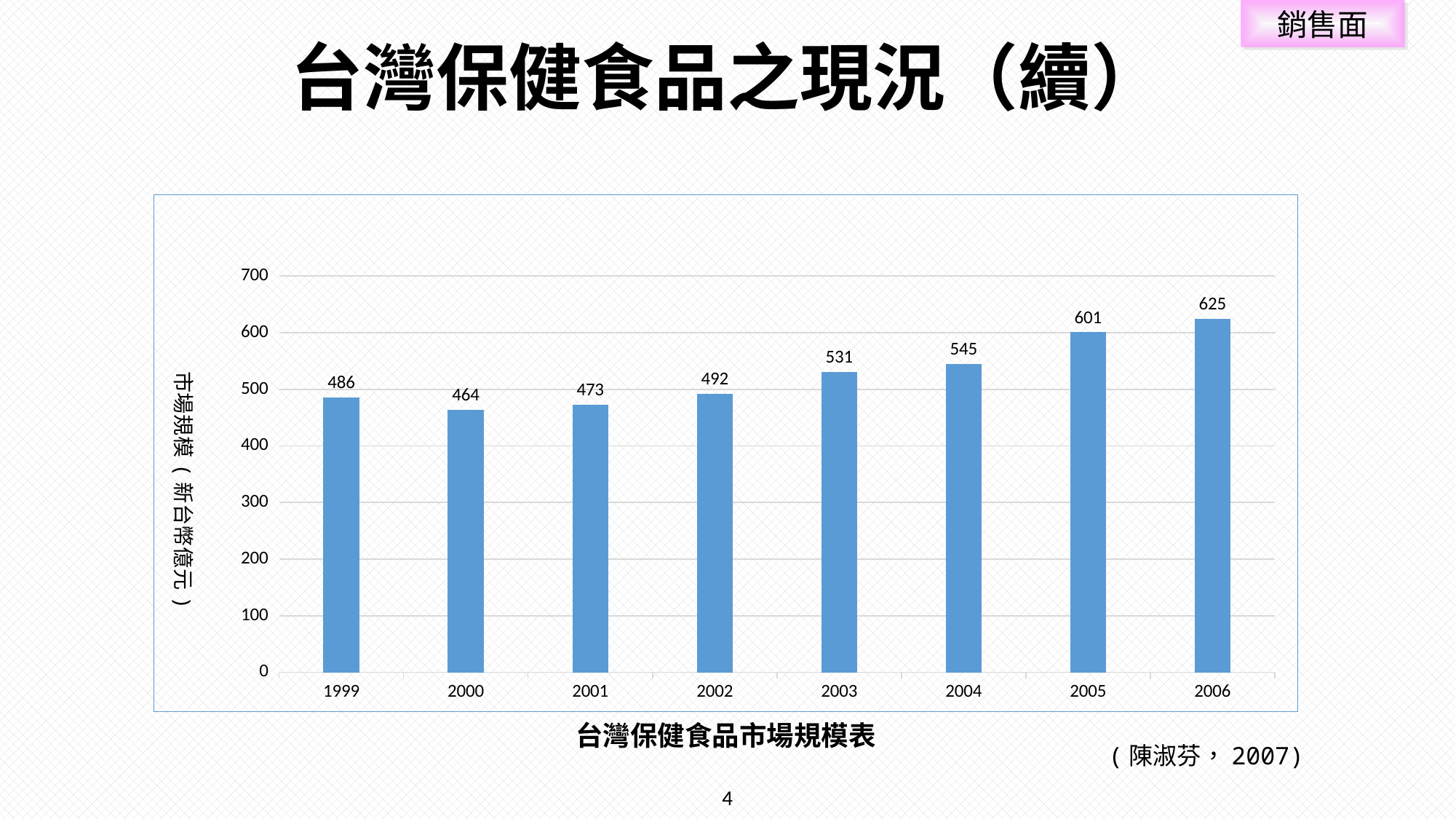
How many years are shown on the x axis? 8 Do the values generally rise or fall from 2000 to 2006? rise What is the market size value for 2003? 531 What is the difference between the market size in 2004 and in 2003? 14 What is the difference between the market size in 2006 and in 2005? 24 Which is larger, the market size in 1999 or in 2001? 1999 What kind of chart is shown on the slide? bar chart What is the market size value for 1999? 486 What is the market size value for 2006? 625 Is the value for 2005 greater or less than 500? greater Which year has the highest market size? 2006 Which year has the lowest market size? 2000